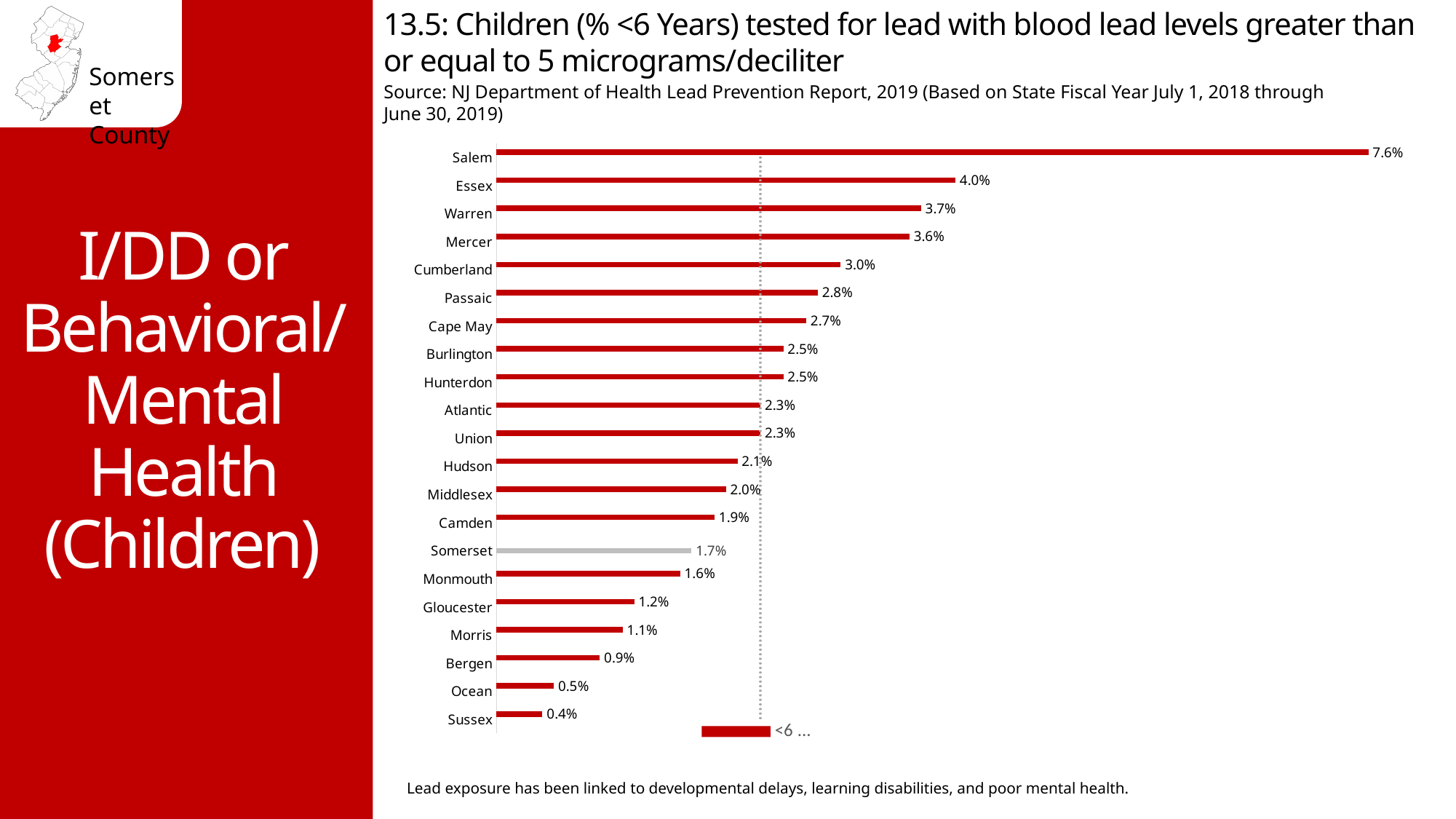
Which has a larger value, Warren or Cumberland? Warren What kind of chart is shown on the slide? Bar chart Which county has the highest value? Salem What is the value for Somerset? 1.7% Which county has the lowest value? Sussex What is the difference between the values for Essex and Somerset? 2.3% What is the value for Bergen? 0.9% What is the value for Salem? 7.6% Which bar is shown in a different colour (grey) from the others? Somerset How many counties are shown in the chart? 21 What is the value for Mercer? 3.6% What is the difference between the values for Salem and Essex? 3.6%